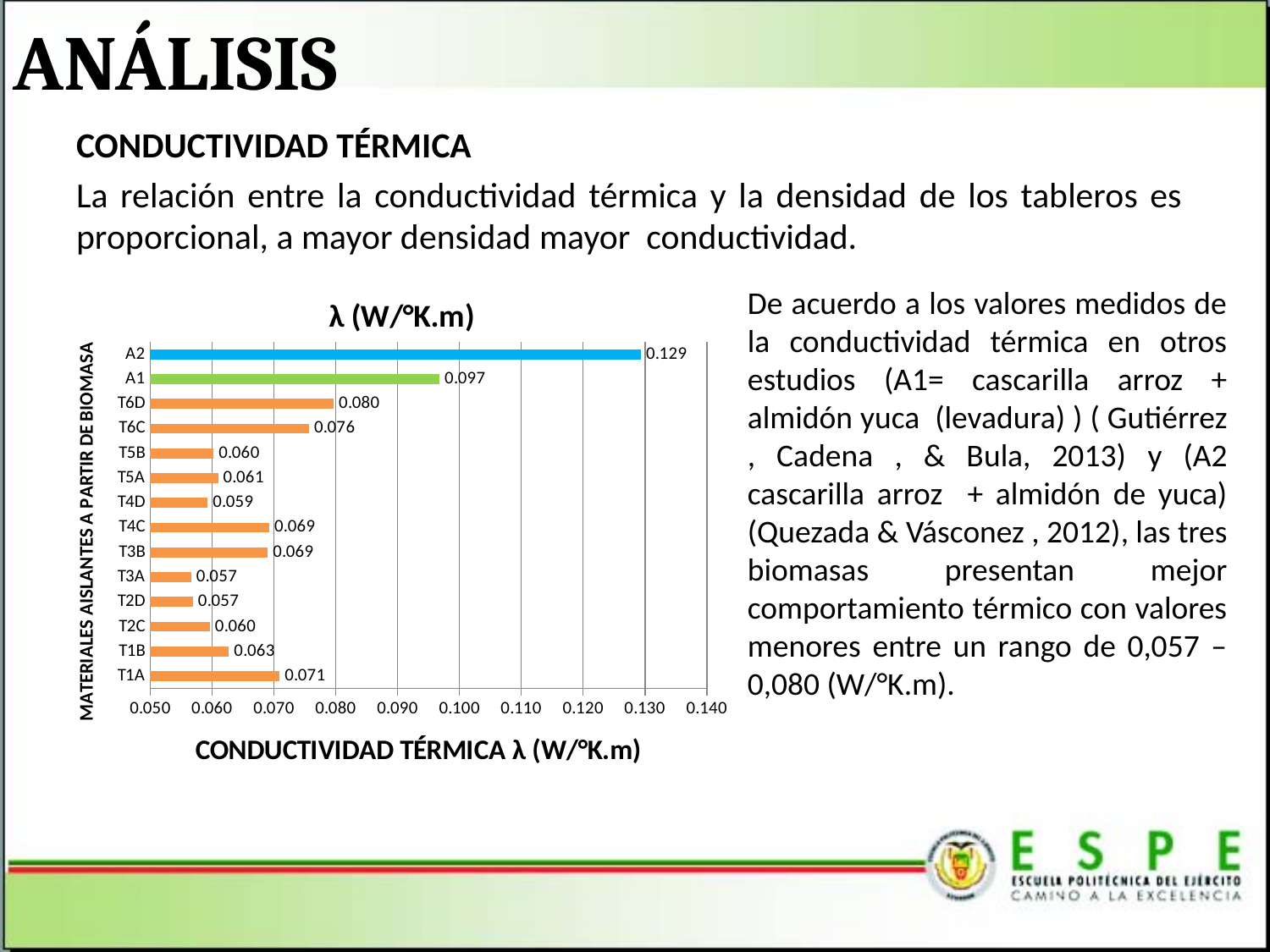
What is the thermal conductivity value shown for A2? 0.129 Which has a larger value, T1A or T1B? T1A What is the value shown for T6D? 0.080 What is the difference between the values for T6D and T6C? 0.004 What is the title of the chart? λ (W/°K.m) What is the value shown for T1A? 0.071 What is the difference between the values for A2 and A1? 0.032 What kind of chart is shown on the slide? Bar chart Which category has the highest value in the chart? A2 Is the value for A1 greater or less than 0.090? greater How many categories (materials) are plotted in the chart? 14 What is the value shown for T4D? 0.059